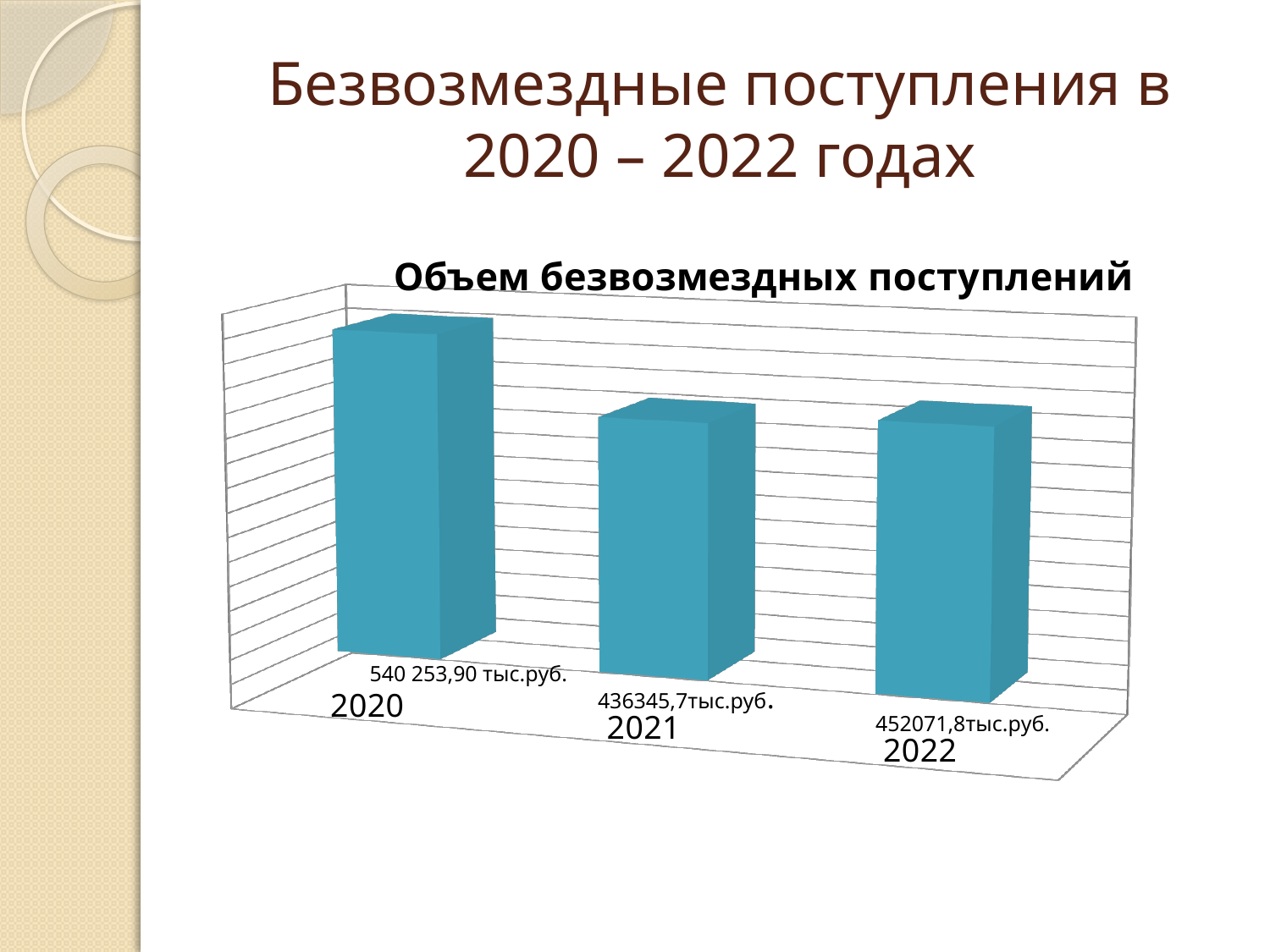
How many years are shown in the chart? 3 By how much does the value for 2020 exceed the value for 2021? 103908,2 тыс.руб. Which year has the highest volume of gratuitous receipts? 2020 Which is larger, the value for 2021 or the value for 2022? 2022 What is the value for 2022? 452071,8 тыс.руб. Does the value rise or fall from 2020 to 2021? Fall What is the value for 2021? 436345,7 тыс.руб. What is the difference between the values for 2022 and 2021? 15726,1 тыс.руб. What kind of chart is shown on the slide? Bar chart What is the title of the chart? Объем безвозмездных поступлений What is the value for 2020? 540 253,90 тыс.руб. Which year has the lowest volume of gratuitous receipts? 2021